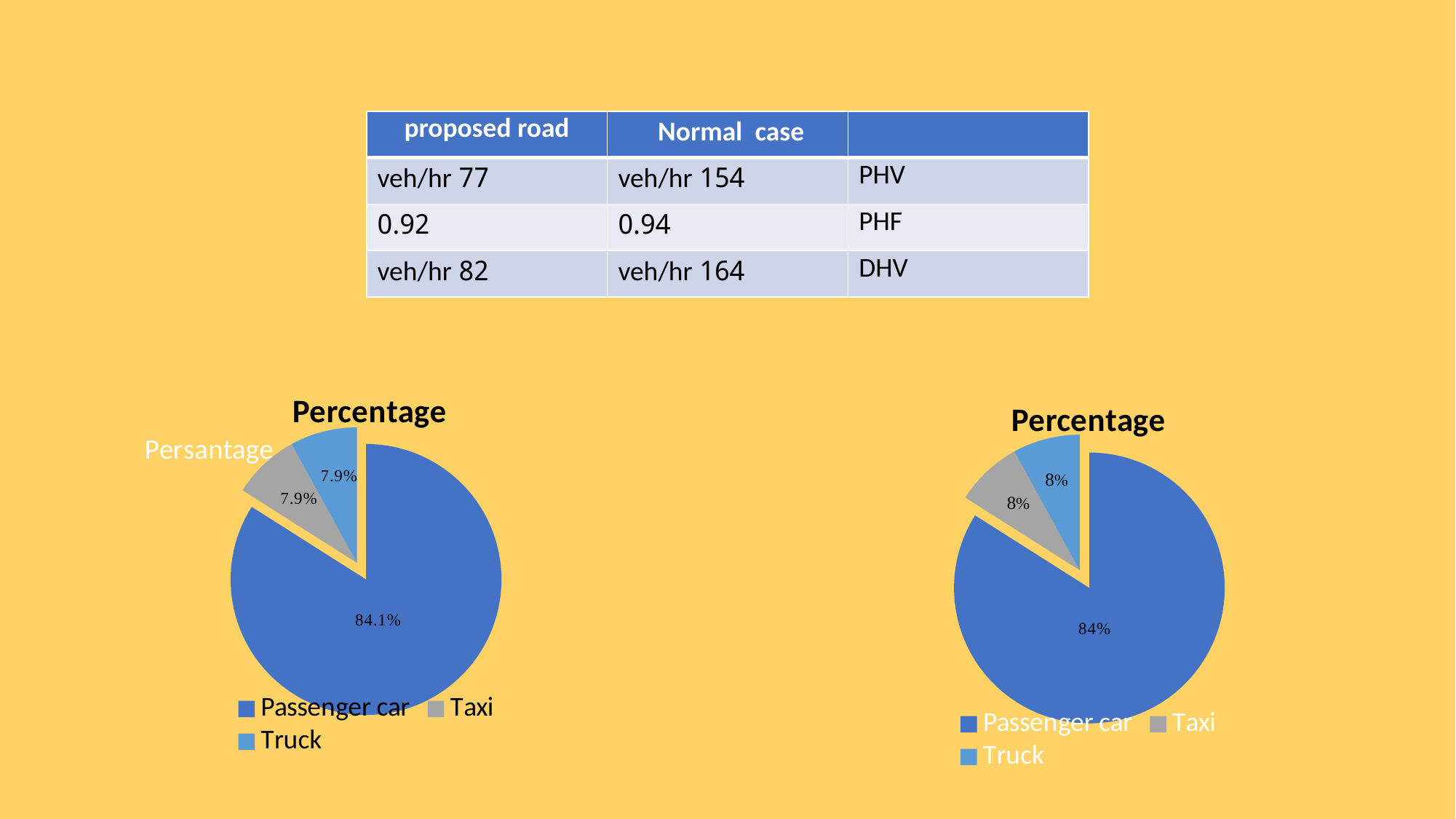
In the right pie chart, what percentage is shown for Passenger car? 84% In the right pie chart, what percentage is shown for Truck? 8% What type of chart is the chart on the left of the slide? pie chart What is the title of the right pie chart? Percentage How many categories does the left pie chart show? 3 In the right pie chart, which category has the largest slice? Passenger car In the left pie chart, is the slice for Passenger car larger or smaller than the slice for Taxi? larger In the left pie chart, which category has the largest slice? Passenger car How many categories does the right pie chart show? 3 Which categories are listed in the legend of the right pie chart? Passenger car, Taxi, Truck In the left pie chart, what percentage is shown for Taxi? 7.9% In the left pie chart, what percentage is shown for Passenger car? 84.1%